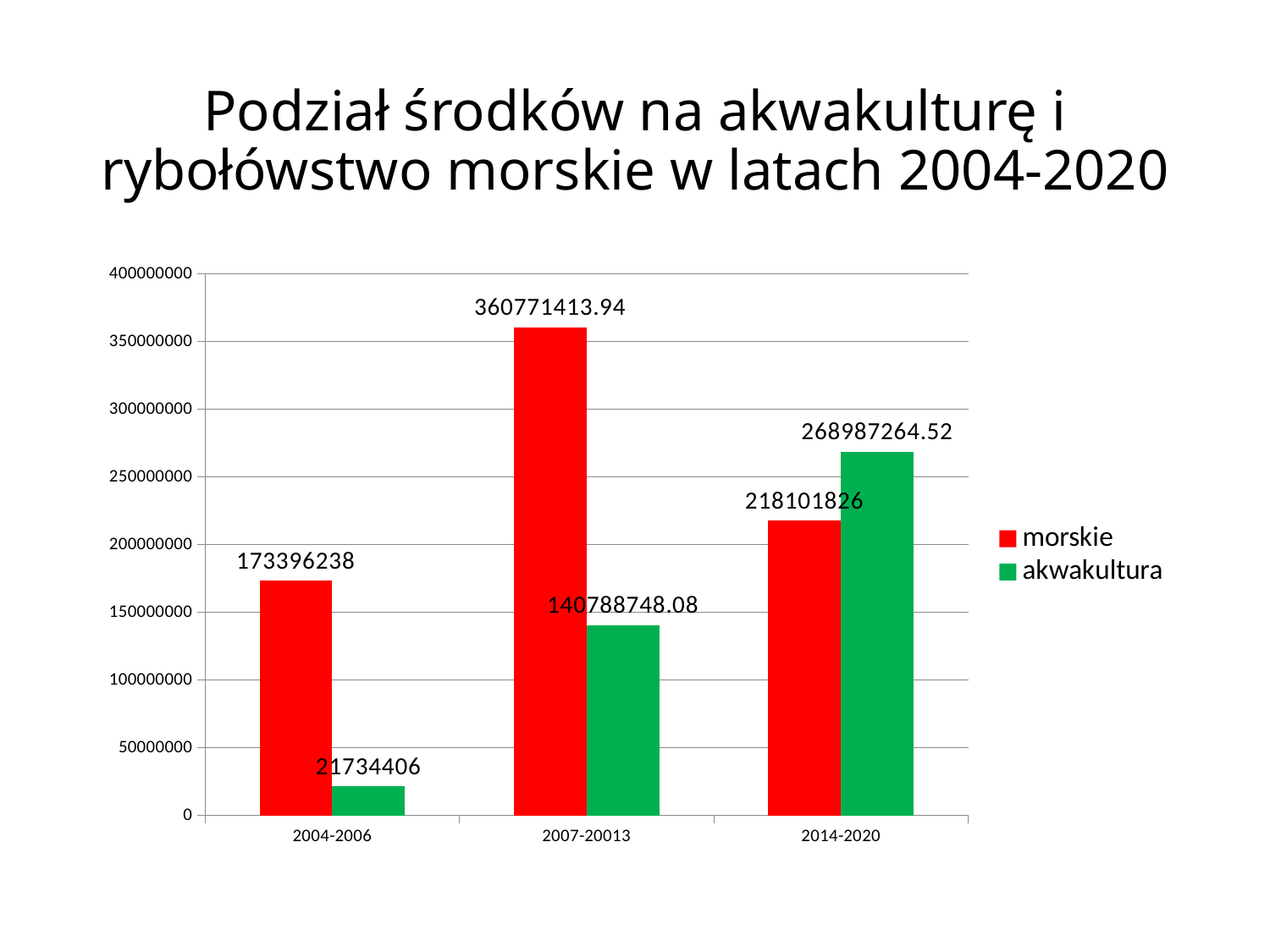
How many series does the legend list? 2 In which period is the morskie value highest? 2007-20013 What is the value for morskie in 2007-20013? 360771413.94 Which is larger in 2007-20013, morskie or akwakultura? morskie Do the akwakultura values rise or fall from 2004-2006 to 2014-2020? rise What is the value for akwakultura in 2004-2006? 21734406 In which period is the akwakultura value lowest? 2004-2006 What is the difference between the akwakultura and morskie values in 2014-2020? 50885438.52 What is the value for akwakultura in 2014-2020? 268987264.52 How many periods are shown on the x axis? 3 What is the difference between the morskie and akwakultura values in 2004-2006? 151661832 What is the value for morskie in 2014-2020? 218101826